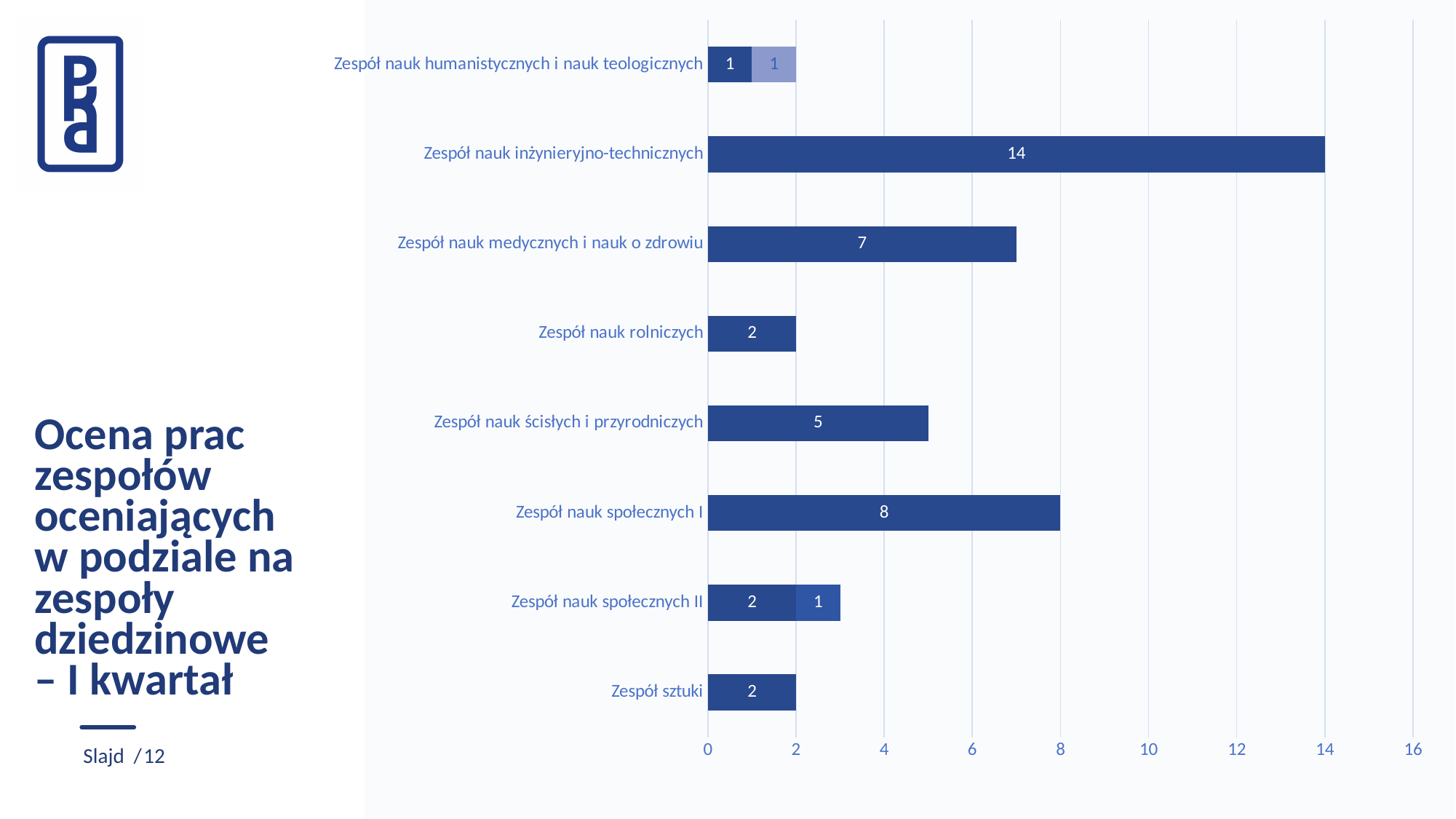
What is the total of the stacked bar for Zespół nauk społecznych II? 3 Which is larger, the value for Zespół nauk medycznych i nauk o zdrowiu or the value for Zespół nauk ścisłych i przyrodniczych? Zespół nauk medycznych i nauk o zdrowiu What is the value shown for Zespół nauk medycznych i nauk o zdrowiu? 7 What is the total of the stacked bar for Zespół nauk humanistycznych i nauk teologicznych? 2 What is the difference between the values for Zespół nauk inżynieryjno-technicznych and Zespół nauk społecznych I? 6 What type of chart is shown on the slide? bar chart How many categories are shown on the chart? 8 What is the value shown for Zespół nauk ścisłych i przyrodniczych? 5 What is the value shown for Zespół nauk inżynieryjno-technicznych? 14 What is the value shown for Zespół nauk społecznych I? 8 Which category has the longest bar? Zespół nauk inżynieryjno-technicznych What is the highest value shown on the horizontal axis? 16